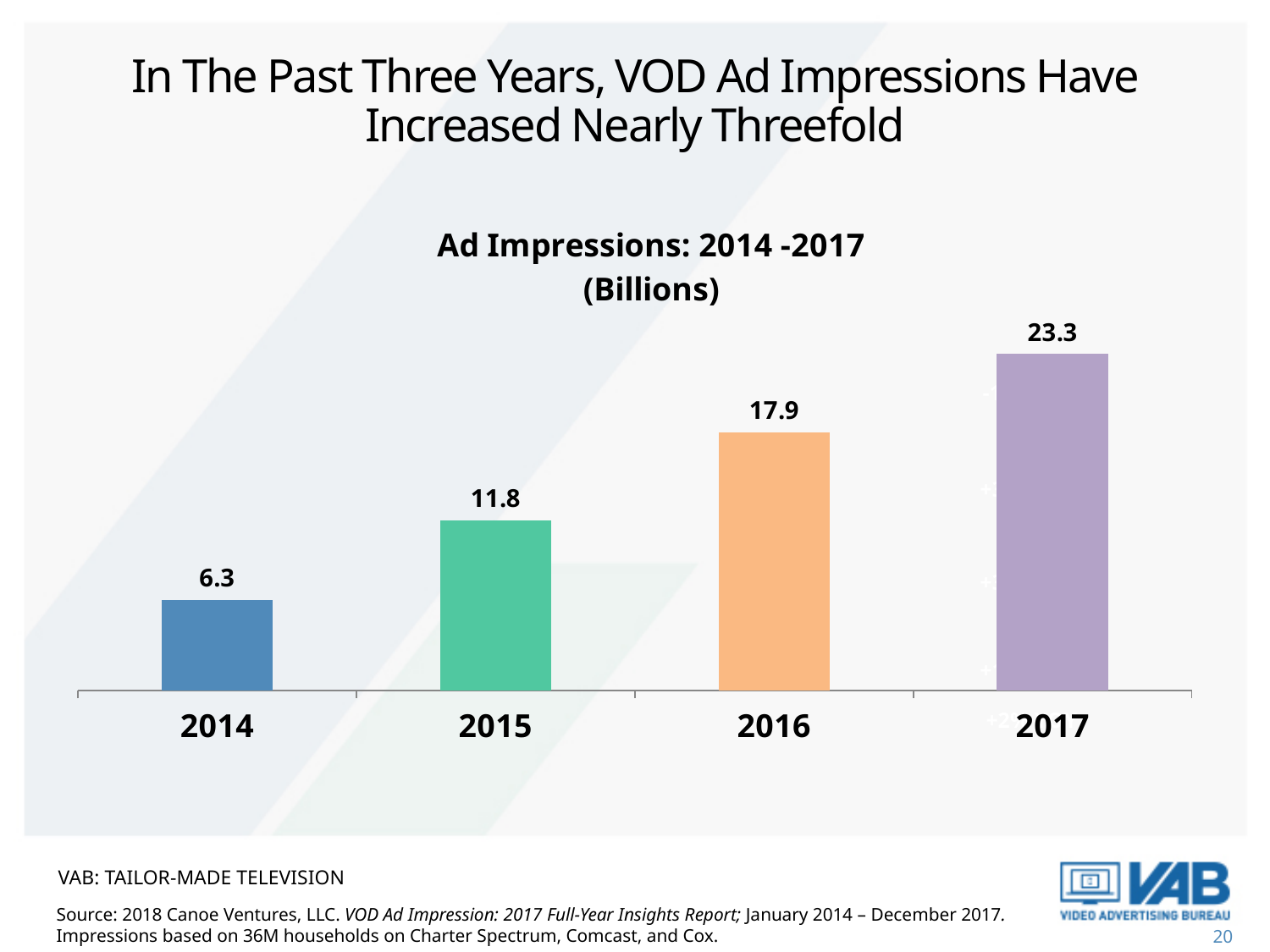
Which year has the highest ad impressions? 2017 What is the value for 2016? 17.9 What is the value for 2017? 23.3 Which year has the lowest ad impressions? 2014 What kind of chart is this? bar chart What is the difference between the values for 2016 and 2015? 6.1 What is the value for 2015? 11.8 How many years are shown on the chart? 4 What is the difference between the values for 2017 and 2014? 17.0 Do the values rise or fall from 2014 to 2017? rise Which is larger, the value for 2015 or the value for 2016? 2016 What is the value for 2014? 6.3